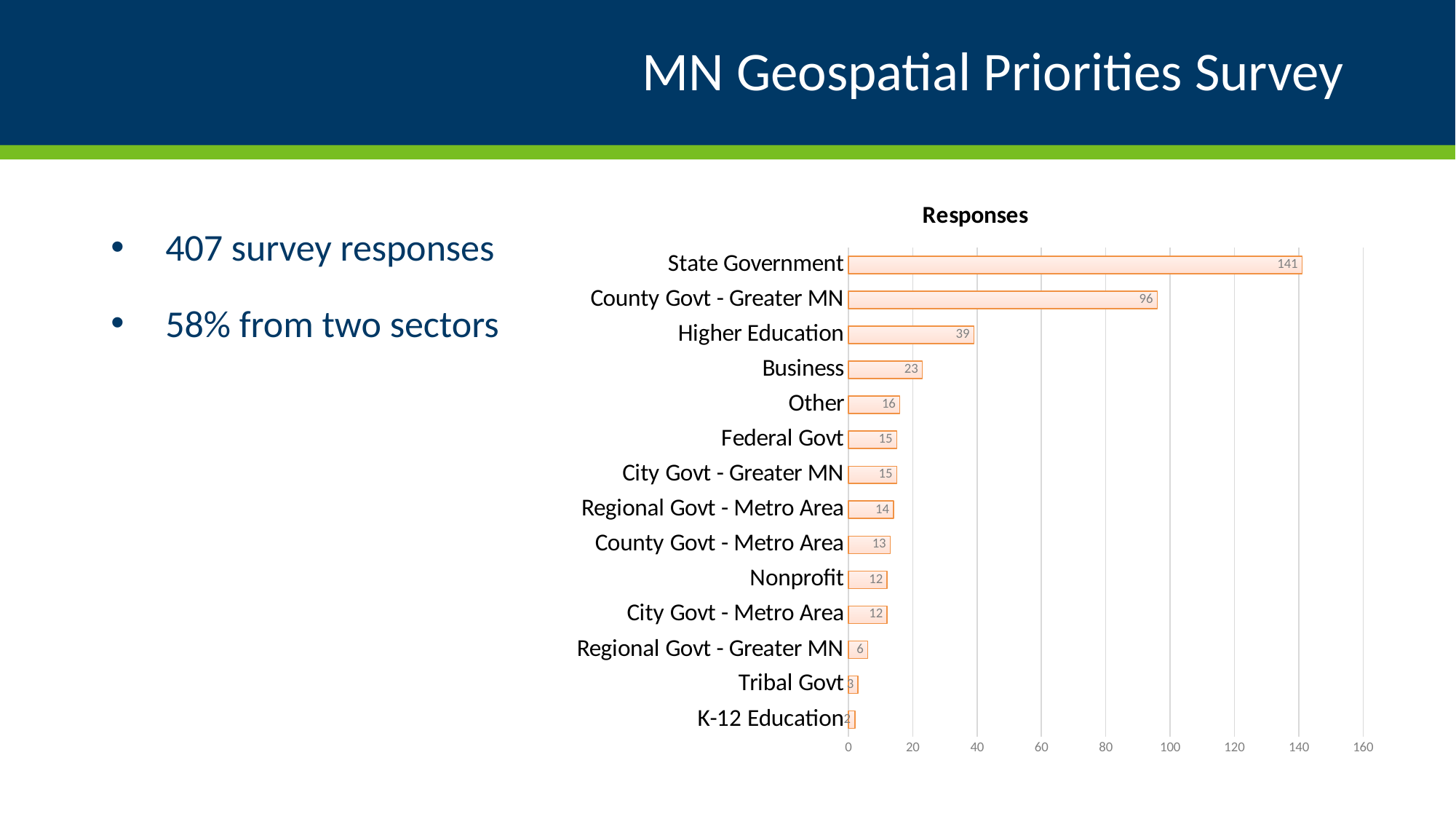
What kind of chart is shown on the slide? bar chart What is the difference between the values for Higher Education and Business? 16 What is the value for Regional Govt - Metro Area? 14 Which is larger, the value for Business or the value for Other? Business Which category has the highest number of responses? State Government Is the value for County Govt - Greater MN greater or less than 100? less What is the value for State Government? 141 What is the value for County Govt - Greater MN? 96 How many categories are shown in the chart? 14 What is the value for Higher Education? 39 What is the title of the chart? Responses What is the difference between the values for State Government and County Govt - Greater MN? 45